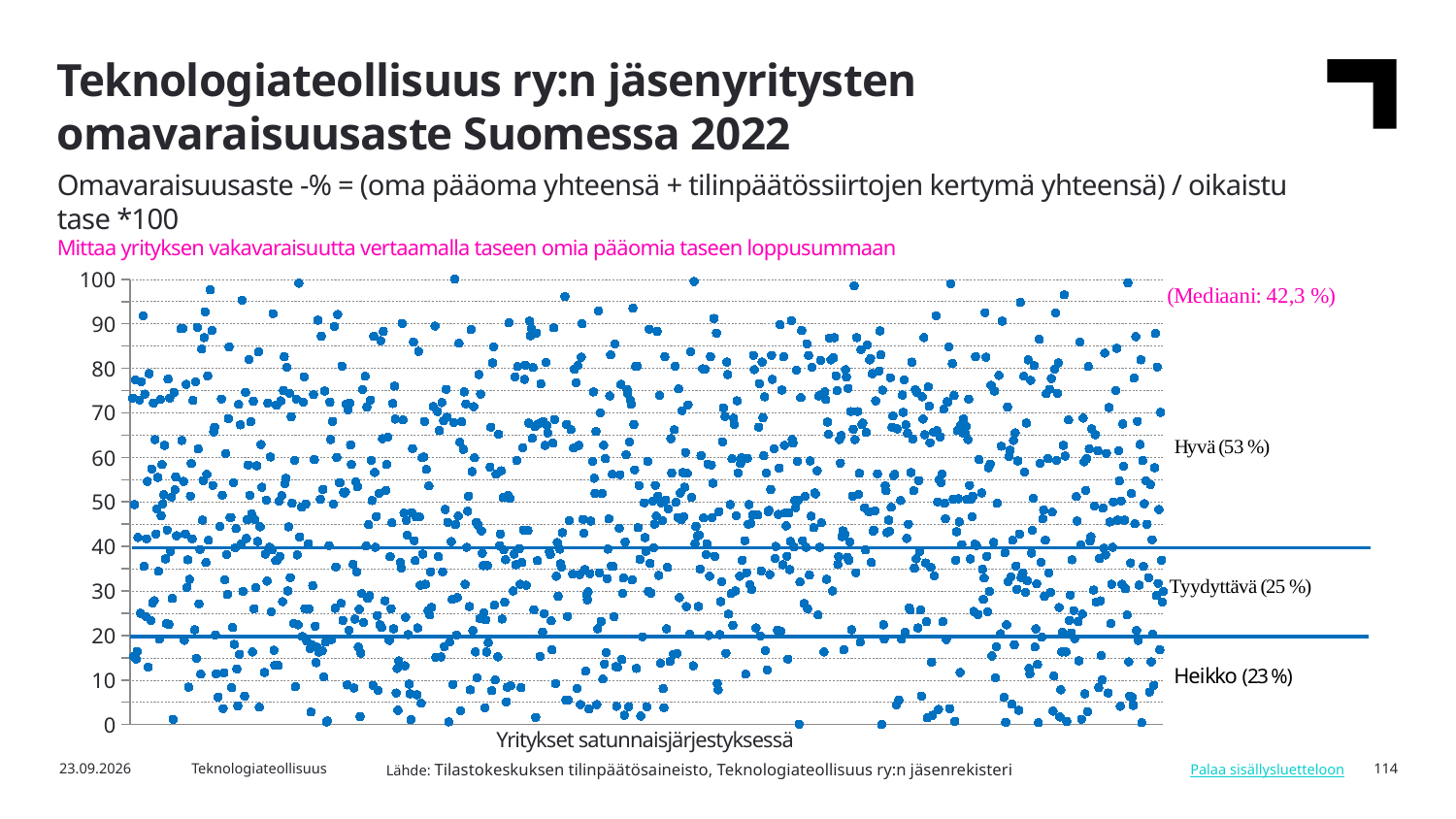
What is the highest value shown on the y axis? 100 What percentage of companies is labelled as 'Tyydyttävä' on the chart? 25 % Is the median value of 42,3 % greater or less than 40? greater Which category has the smallest share of companies: Hyvä, Tyydyttävä or Heikko? Heikko What percentage of companies is labelled as 'Heikko' on the chart? 23 % What median value is printed on the chart? 42,3 % What kind of chart is shown on the slide? Scatter chart At which y-axis values are the two horizontal reference lines drawn? 40 and 20 What is the difference in percentage points between the Hyvä share and the Heikko share? 30 Which category has the largest share of companies: Hyvä, Tyydyttävä or Heikko? Hyvä What percentage of companies is labelled as 'Hyvä' on the chart? 53 % Is the share of companies in the Tyydyttävä category larger than the share in the Heikko category? Yes